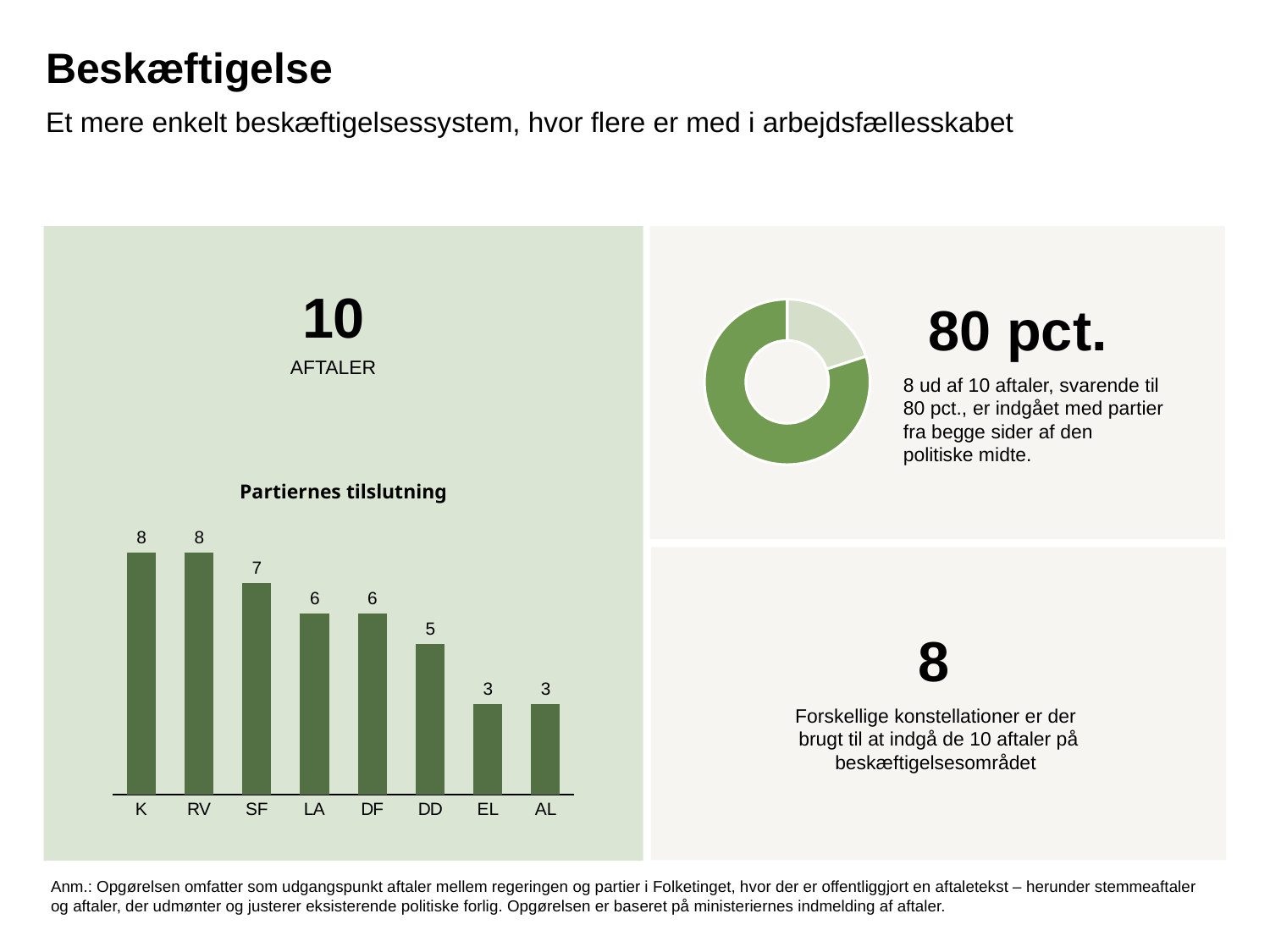
How many categories are shown in the 'Partiernes tilslutning' chart? 8 What kind of chart is shown in the top-right panel next to '80 pct.'? Donut chart In the 'Partiernes tilslutning' chart, what is the value for LA? 6 In the 'Partiernes tilslutning' chart, what is the value for SF? 7 In the 'Partiernes tilslutning' chart, do the values rise or fall from left to right along the x axis? Fall In the 'Partiernes tilslutning' chart, which categories have the lowest value? EL and AL In the 'Partiernes tilslutning' chart, which is larger, the value for RV or the value for DF? RV In the 'Partiernes tilslutning' chart, what is the value for DD? 5 In the 'Partiernes tilslutning' chart, what is the difference between the values for SF and DD? 2 What kind of chart is 'Partiernes tilslutning'? Bar chart In the 'Partiernes tilslutning' chart, what is the difference between the values for K and EL? 5 In the 'Partiernes tilslutning' chart, which categories have the highest value? K and RV